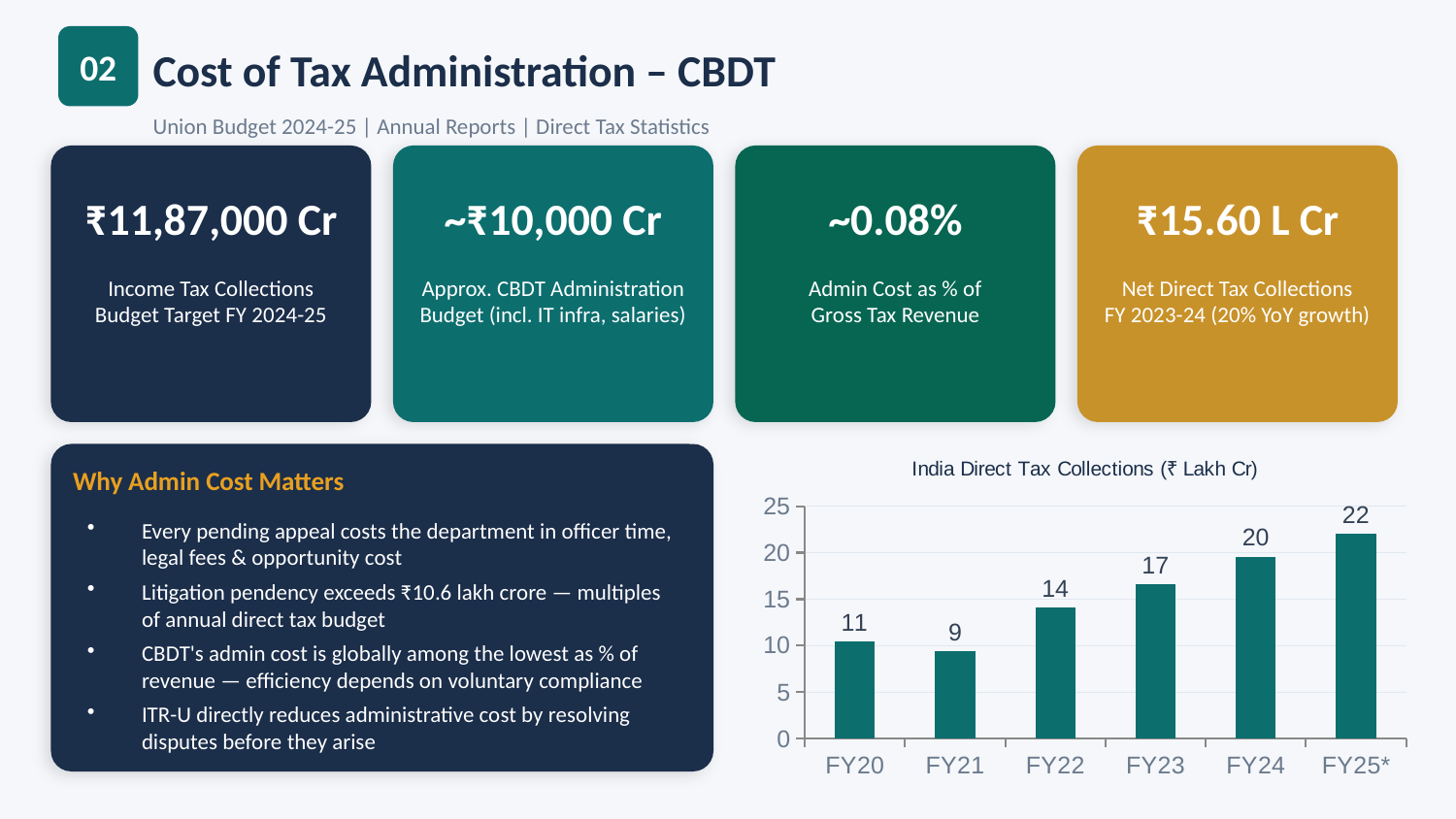
Which fiscal year has the highest value in the India Direct Tax Collections chart? FY25* What is the difference between the FY24 and FY23 values in the India Direct Tax Collections chart? 3 Is the value for FY23 in the India Direct Tax Collections chart greater or less than 15? greater What is the title of the chart on the slide? India Direct Tax Collections (₹ Lakh Cr) Which is larger in the India Direct Tax Collections chart, the value for FY20 or FY21? FY20 What is the value for FY20 in the India Direct Tax Collections chart? 11 What is the value for FY25* in the India Direct Tax Collections chart? 22 What kind of chart is the India Direct Tax Collections chart? bar chart How many fiscal years are shown on the x axis of the India Direct Tax Collections chart? 6 From FY21 to FY25*, do the values in the India Direct Tax Collections chart rise or fall? rise Which fiscal year has the lowest value in the India Direct Tax Collections chart? FY21 What is the value for FY22 in the India Direct Tax Collections chart? 14